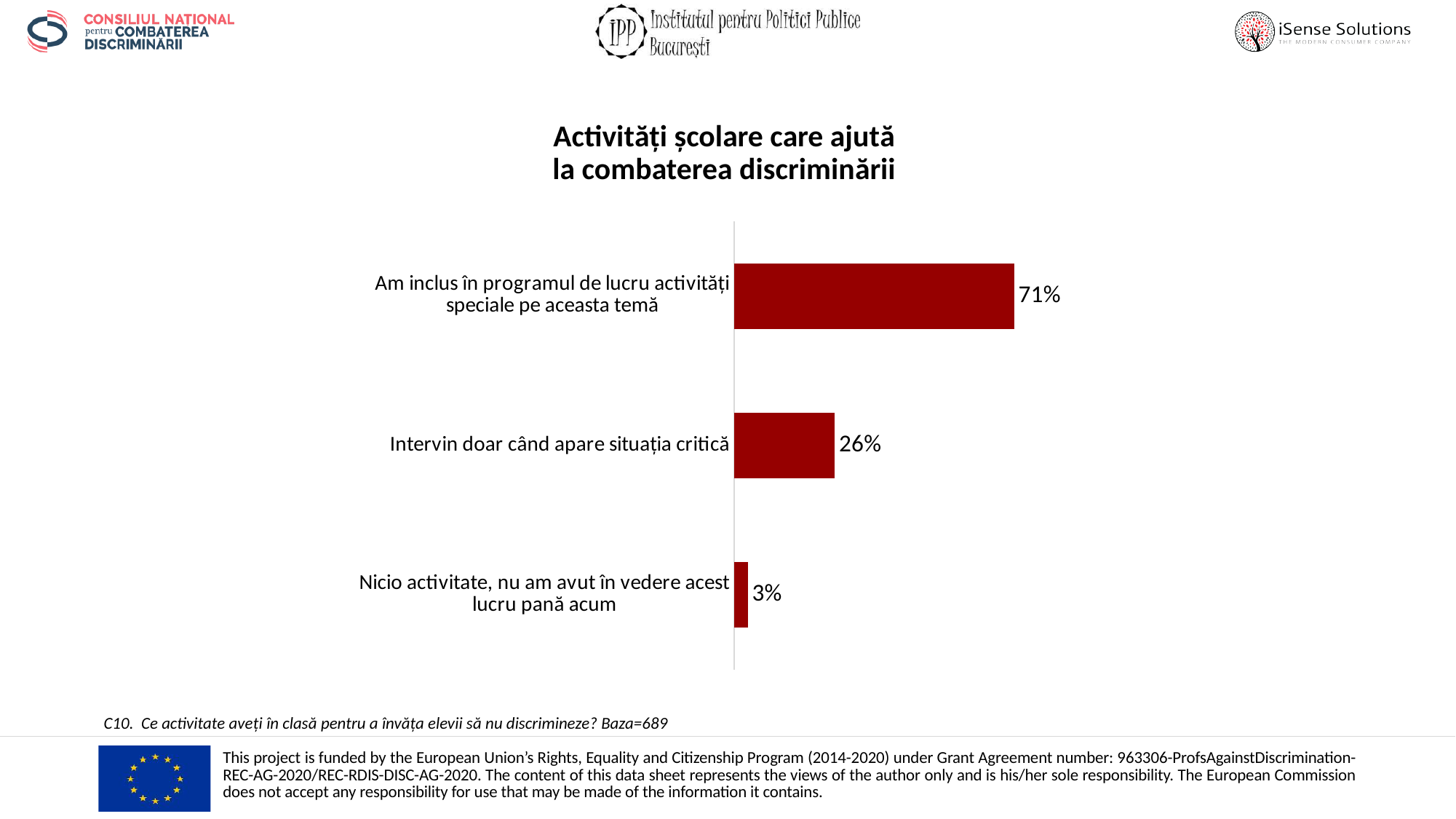
What percentage is shown for "Nicio activitate, nu am avut în vedere acest lucru pană acum"? 3% What is the value for "Intervin doar când apare situația critică"? 26% What is the base (Baza) stated for question C10 below the chart? 689 Which category has the lowest value? Nicio activitate, nu am avut în vedere acest lucru pană acum What is the title of the chart? Activități școlare care ajută la combaterea discriminării What percentage is shown for "Am inclus în programul de lucru activități speciale pe aceasta temă"? 71% Which category has the highest value? Am inclus în programul de lucru activități speciale pe aceasta temă How many categories are shown in the chart? 3 Which is larger: the value for "Intervin doar când apare situația critică" or for "Nicio activitate, nu am avut în vedere acest lucru pană acum"? Intervin doar când apare situația critică What is the difference between the values for "Intervin doar când apare situația critică" and "Nicio activitate, nu am avut în vedere acest lucru pană acum"? 23% What is the difference between the values for "Am inclus în programul de lucru activități speciale pe aceasta temă" and "Intervin doar când apare situația critică"? 45% What type of chart is shown on the slide? Bar chart